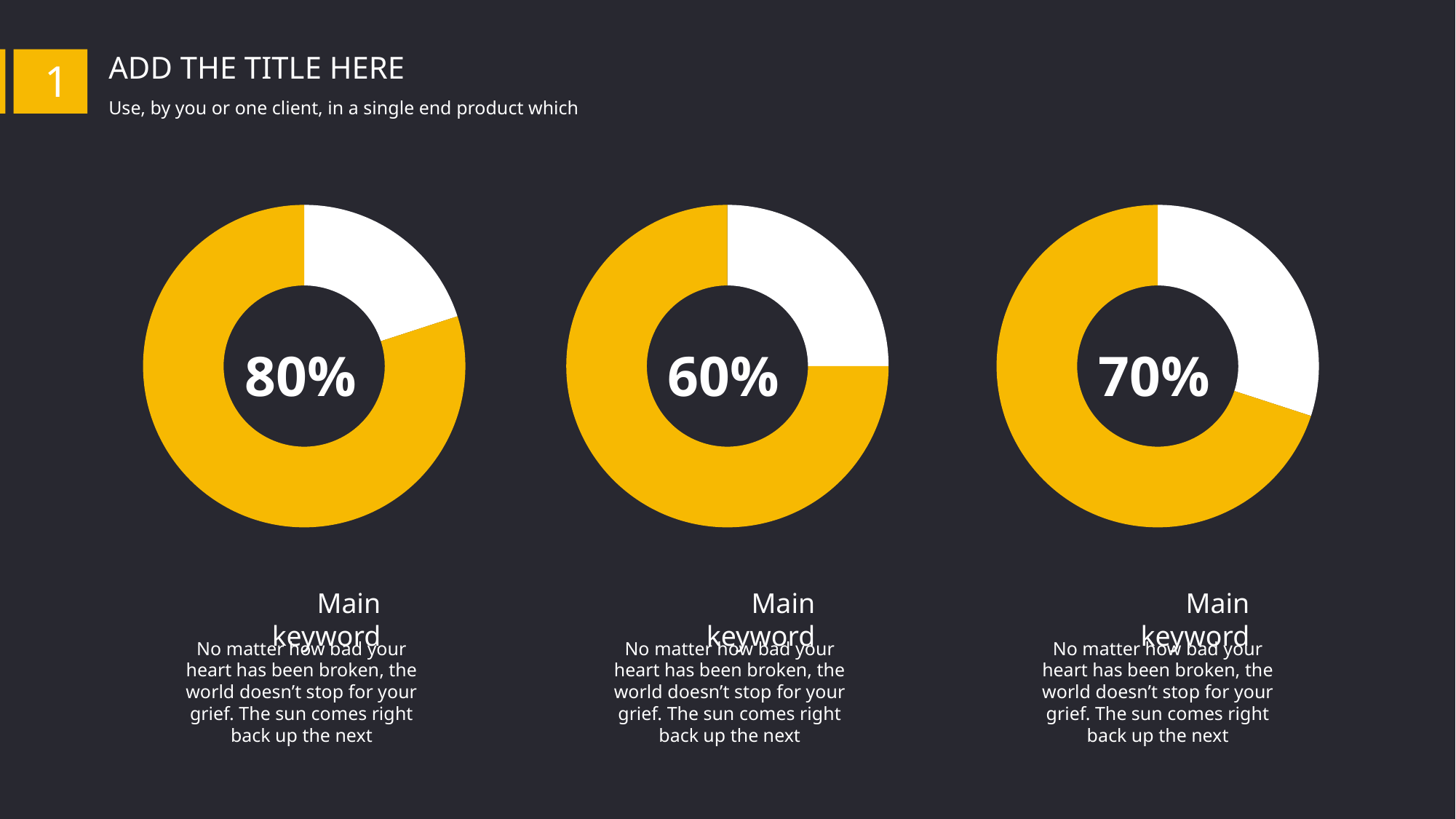
Which is larger, the percentage in the right donut chart or the percentage in the middle donut chart? The right chart (70%) What is the difference between the percentage in the left donut chart and the percentage in the middle donut chart? 20% What colour is used for the filled portion of each donut chart? Yellow What kind of chart is used to display the percentages on this slide? Donut (pie) chart What value is shown in the centre of the left donut chart? 80% What value is shown in the centre of the middle donut chart? 60% Which of the three donut charts shows the lowest percentage? The middle chart (60%) How many donut charts are on the slide? 3 What is the difference between the percentage in the right donut chart and the percentage in the middle donut chart? 10% In the left donut chart, what share of the ring is filled in yellow? 80% Which of the three donut charts shows the highest percentage? The left chart (80%) What value is shown in the centre of the right donut chart? 70%